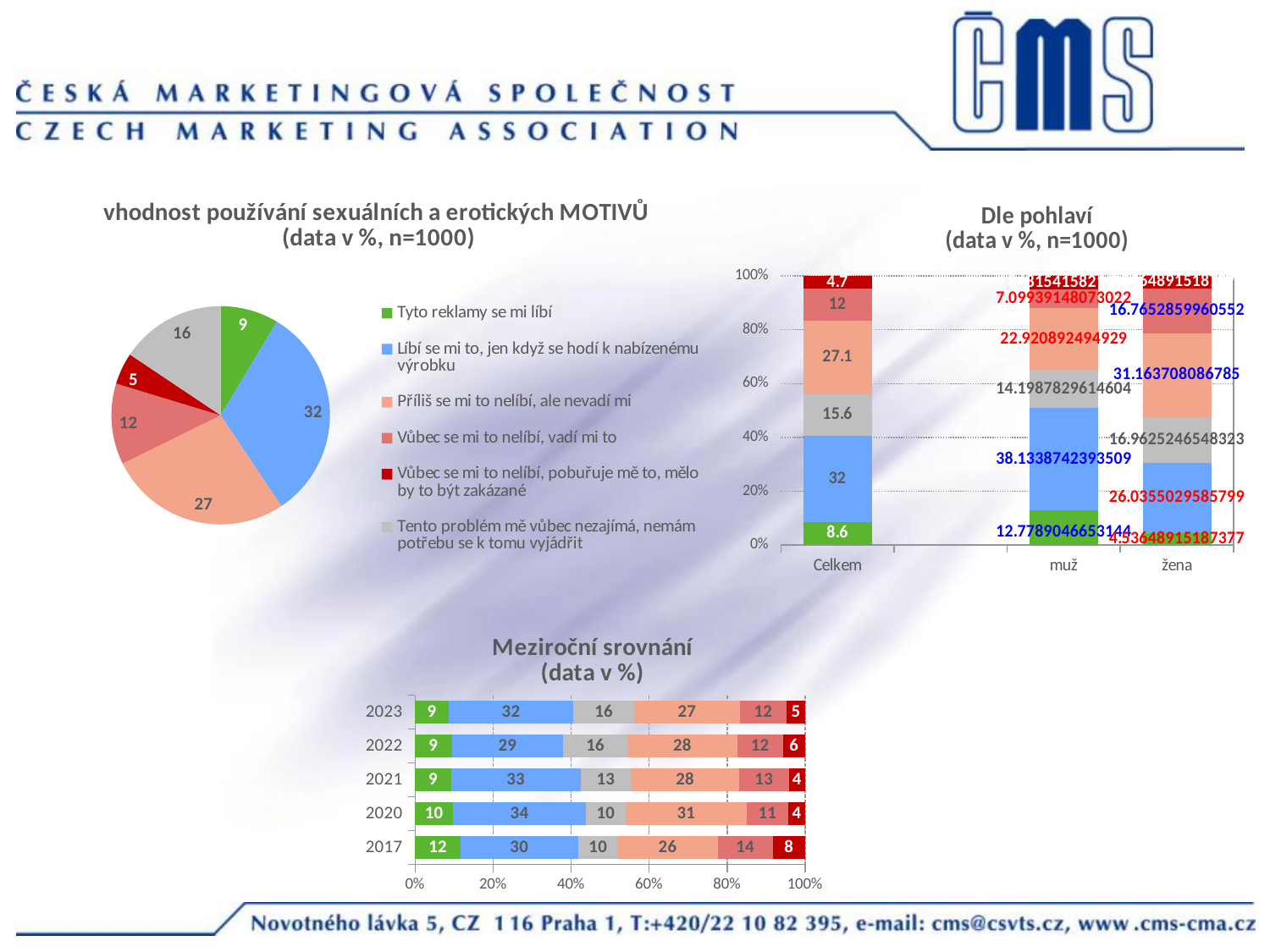
In the 'Meziroční srovnání' chart, what is the value of the blue segment for 2020? 34 In the pie chart 'vhodnost používání sexuálních a erotických MOTIVŮ', what is the value of the smallest slice? 5 In the 'Dle pohlaví' chart, what is the value of the blue segment in the 'Celkem' bar? 32 In the pie chart 'vhodnost používání sexuálních a erotických MOTIVŮ', what is the value of the green slice ('Tyto reklamy se mi líbí')? 9 How many years are shown in the 'Meziroční srovnání' chart? 5 How many entries does the legend of the pie chart 'vhodnost používání sexuálních a erotických MOTIVŮ' list? 6 In the 'Dle pohlaví' chart, what is the value of the topmost (dark red) segment of the 'Celkem' bar? 4.7 In the pie chart 'vhodnost používání sexuálních a erotických MOTIVŮ', what is the difference between the 32 slice and the 27 slice? 5 In the pie chart 'vhodnost používání sexuálních a erotických MOTIVŮ', what is the value of the largest slice? 32 In the 'Dle pohlaví' chart, what is the value of the green segment at the bottom of the 'Celkem' bar? 8.6 In the 'Meziroční srovnání' chart, which year has the larger dark red (last) segment, 2017 or 2023? 2017 What kind of chart is 'Meziroční srovnání (data v %)'? stacked bar chart